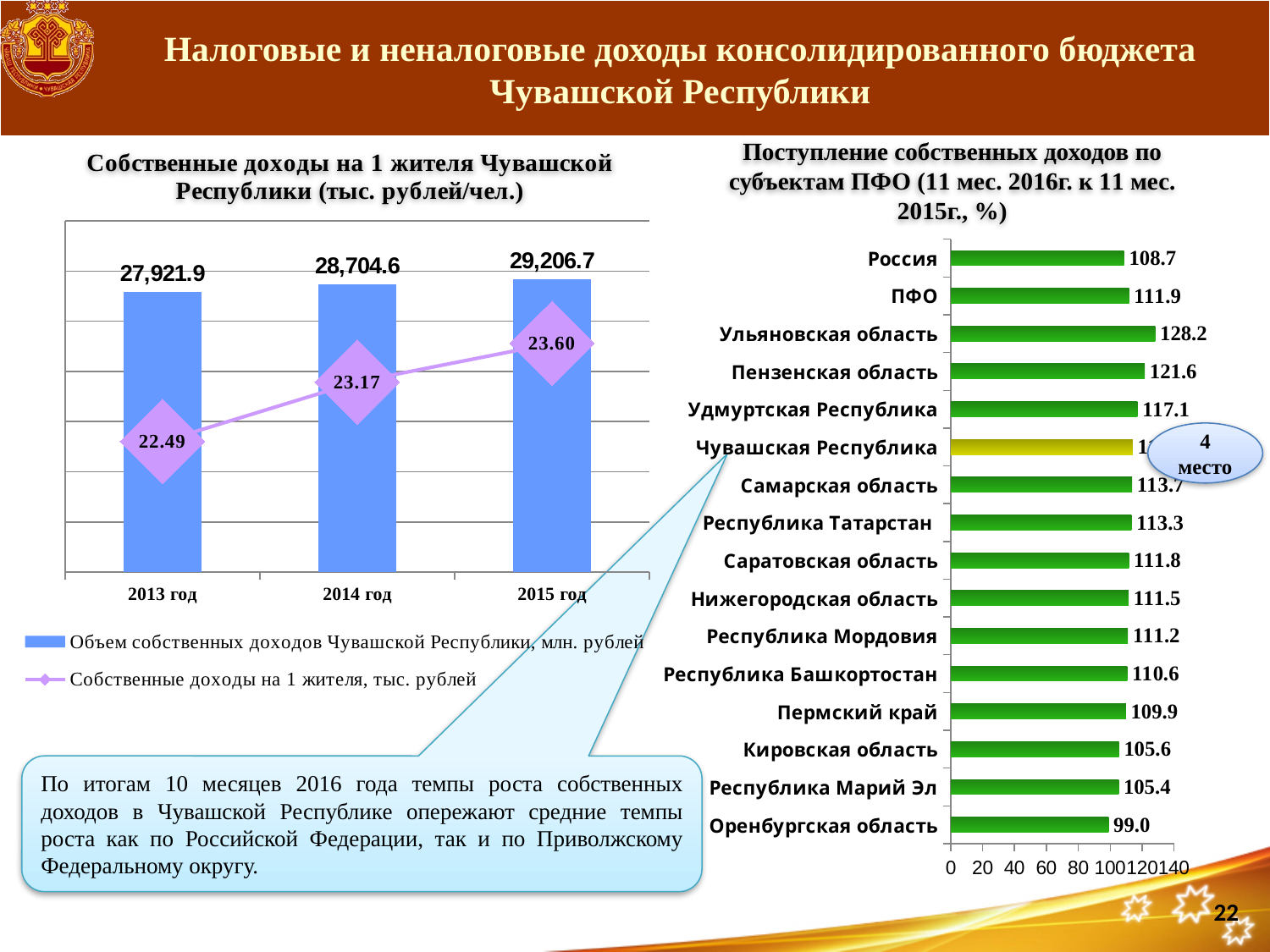
How many categories are shown in the right chart 'Поступление собственных доходов по субъектам ПФО'? 16 In the left chart 'Собственные доходы на 1 жителя Чувашской Республики', what is the value of the line point for 2013 год? 22.49 How many series does the legend of the left chart 'Собственные доходы на 1 жителя Чувашской Республики' list? 2 In the right chart 'Поступление собственных доходов по субъектам ПФО', what is the value for Пензенская область? 121.6 What type of chart is the right chart 'Поступление собственных доходов по субъектам ПФО'? bar chart In the left chart 'Собственные доходы на 1 жителя Чувашской Республики', do the line values rise or fall from 2013 год to 2015 год? rise In the left chart 'Собственные доходы на 1 жителя Чувашской Республики', what is the value of the bar for 2015 год? 29,206.7 In the right chart 'Поступление собственных доходов по субъектам ПФО', which category has the highest value? Ульяновская область In the right chart 'Поступление собственных доходов по субъектам ПФО', what is the difference between the values for Удмуртская Республика and Самарская область? 3.4 In the left chart 'Собственные доходы на 1 жителя Чувашской Республики', what is the difference between the bar values for 2014 год and 2013 год? 782.7 In the right chart 'Поступление собственных доходов по субъектам ПФО', which category has the lowest value? Оренбургская область In the right chart 'Поступление собственных доходов по субъектам ПФО', which is larger: the value for Россия or the value for ПФО? ПФО